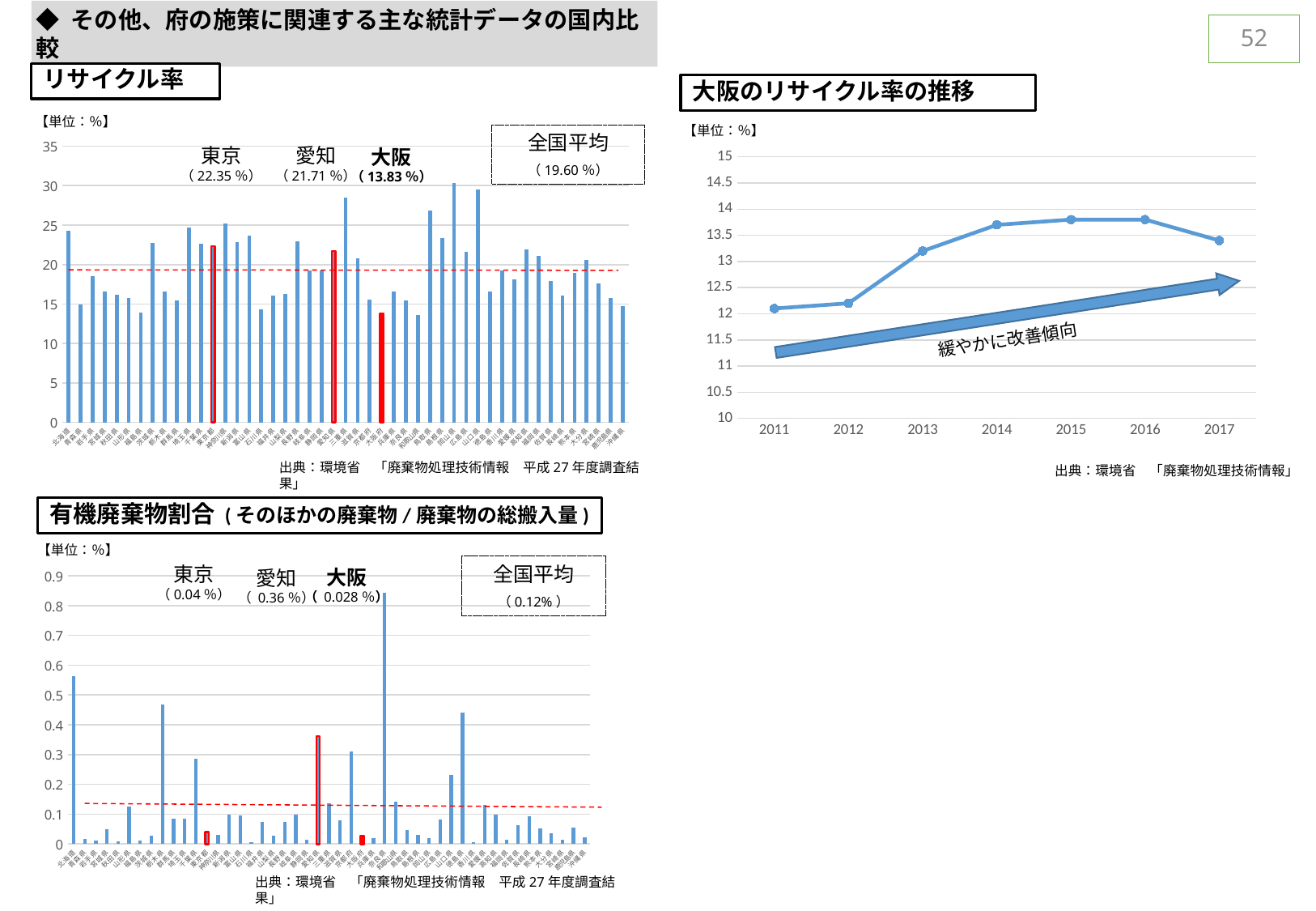
What kind of chart is the 大阪のリサイクル率の推移 chart? line chart In the 大阪のリサイクル率の推移 chart, is the value for 2011 greater or less than 12.5? less What kind of chart is the リサイクル率 chart? bar chart In the リサイクル率 chart, what is the 全国平均 (national average) value shown? 19.60 % In the リサイクル率 chart, what is the difference between the values shown for 東京 and 大阪? 8.52 % In the 大阪のリサイクル率の推移 chart, how many years are plotted on the x axis? 7 In the 有機廃棄物割合 chart, which has the higher value, 東京 or 大阪? 東京 In the リサイクル率 chart, what is the recycling rate shown for 東京? 22.35 % In the リサイクル率 chart, what is the recycling rate shown for 大阪? 13.83 % In the 大阪のリサイクル率の推移 chart, do the values rise or fall from 2011 to 2016? rise In the 有機廃棄物割合 chart, what is the value shown for 愛知? 0.36 % In the リサイクル率 chart, which has the higher recycling rate, 愛知 or 大阪? 愛知